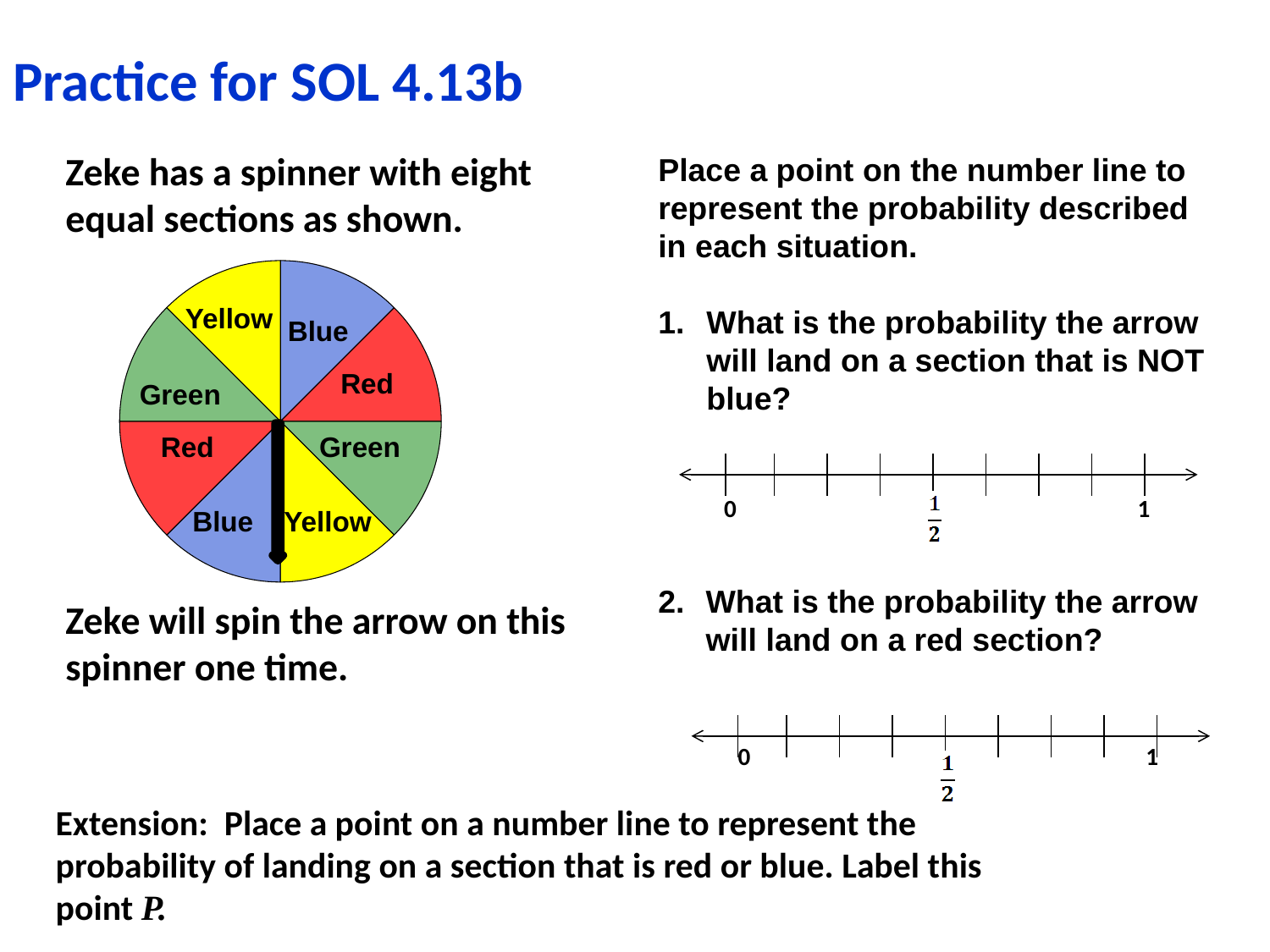
What three values are labeled on the first number line? 0, 1/2, 1 How many different colours appear on the spinner? 4 How many sections of the spinner are labeled Green? 2 How many sections of the spinner are labeled Blue? 2 What fraction of the spinner does a single section represent? 1/8 What is the title of the slide containing the spinner? Practice for SOL 4.13b What colour is the arrow on the spinner? Black